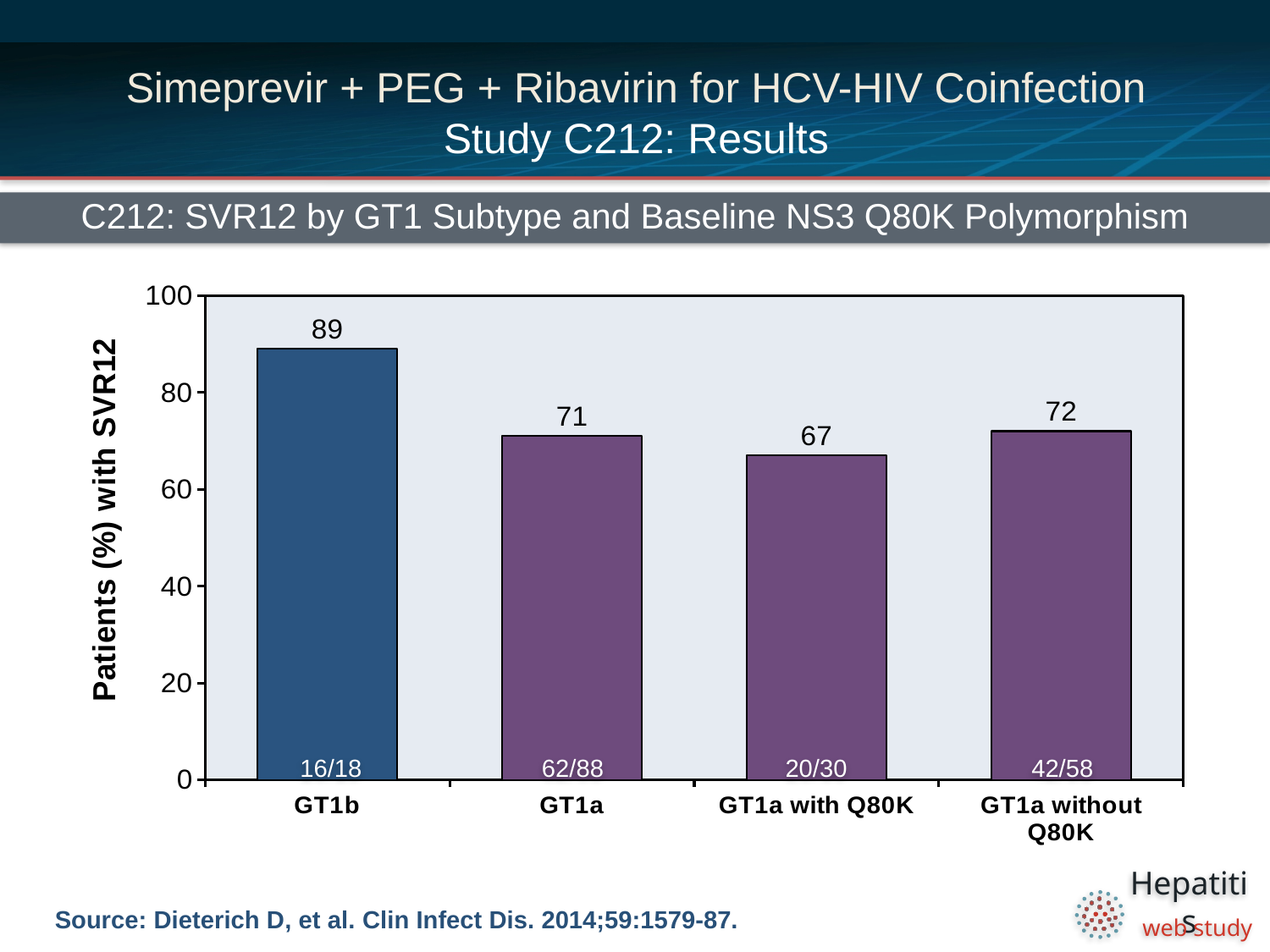
What is the difference in SVR12 rate between GT1b and GT1a? 18 What fraction of patients is shown at the base of the GT1a bar? 62/88 What is the SVR12 rate for GT1a without Q80K? 72 What is the SVR12 rate for GT1b? 89 Which has a higher SVR12 rate, GT1b or GT1a without Q80K? GT1b What type of chart is shown on the slide? Bar chart Which category has the lowest SVR12 rate? GT1a with Q80K How many categories are shown on the x axis? 4 What is the difference in SVR12 rate between GT1a without Q80K and GT1a with Q80K? 5 What is the label of the y axis? Patients (%) with SVR12 Which category has the highest SVR12 rate? GT1b What is the SVR12 rate for GT1a with Q80K? 67